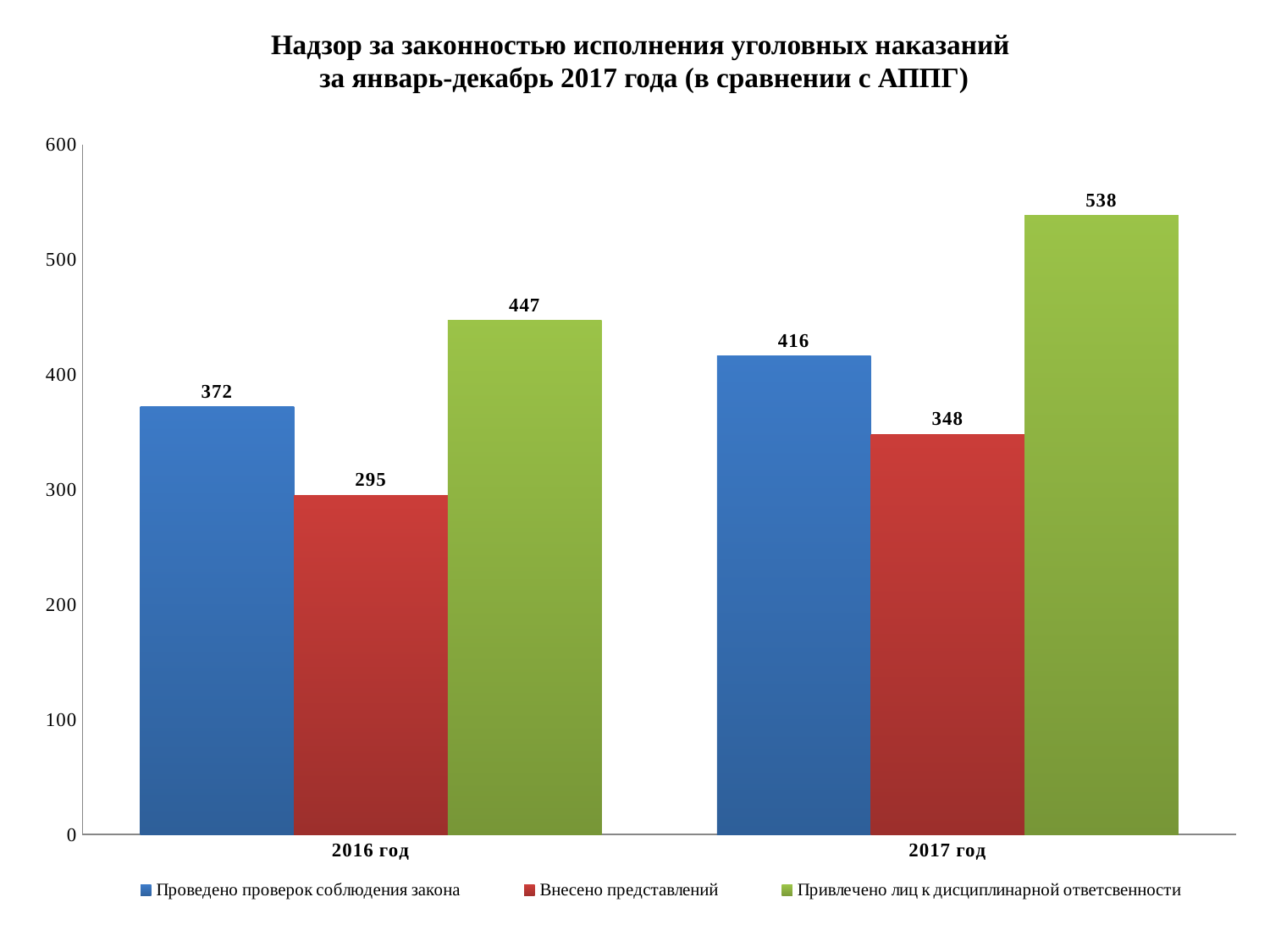
What is the value of "Внесено представлений" for 2017 год? 348 What is the value of "Проведено проверок соблюдения закона" for 2016 год? 372 How many categories are shown on the x axis? 2 Which series has the highest value in 2017 год? Привлечено лиц к дисциплинарной ответсвенности What is the value of "Привлечено лиц к дисциплинарной ответсвенности" for 2016 год? 447 Which series has the lowest value in 2016 год? Внесено представлений How many series does the legend list? 3 What is the difference between the 2017 год and 2016 год values for "Привлечено лиц к дисциплинарной ответсвенности"? 91 Is the value for "Внесено представлений" in 2016 год greater or less than 300? less Which is larger: "Проведено проверок соблюдения закона" in 2016 год or in 2017 год? 2017 год What is the difference between "Проведено проверок соблюдения закона" and "Внесено представлений" in 2017 год? 68 What kind of chart is shown on the slide? bar chart